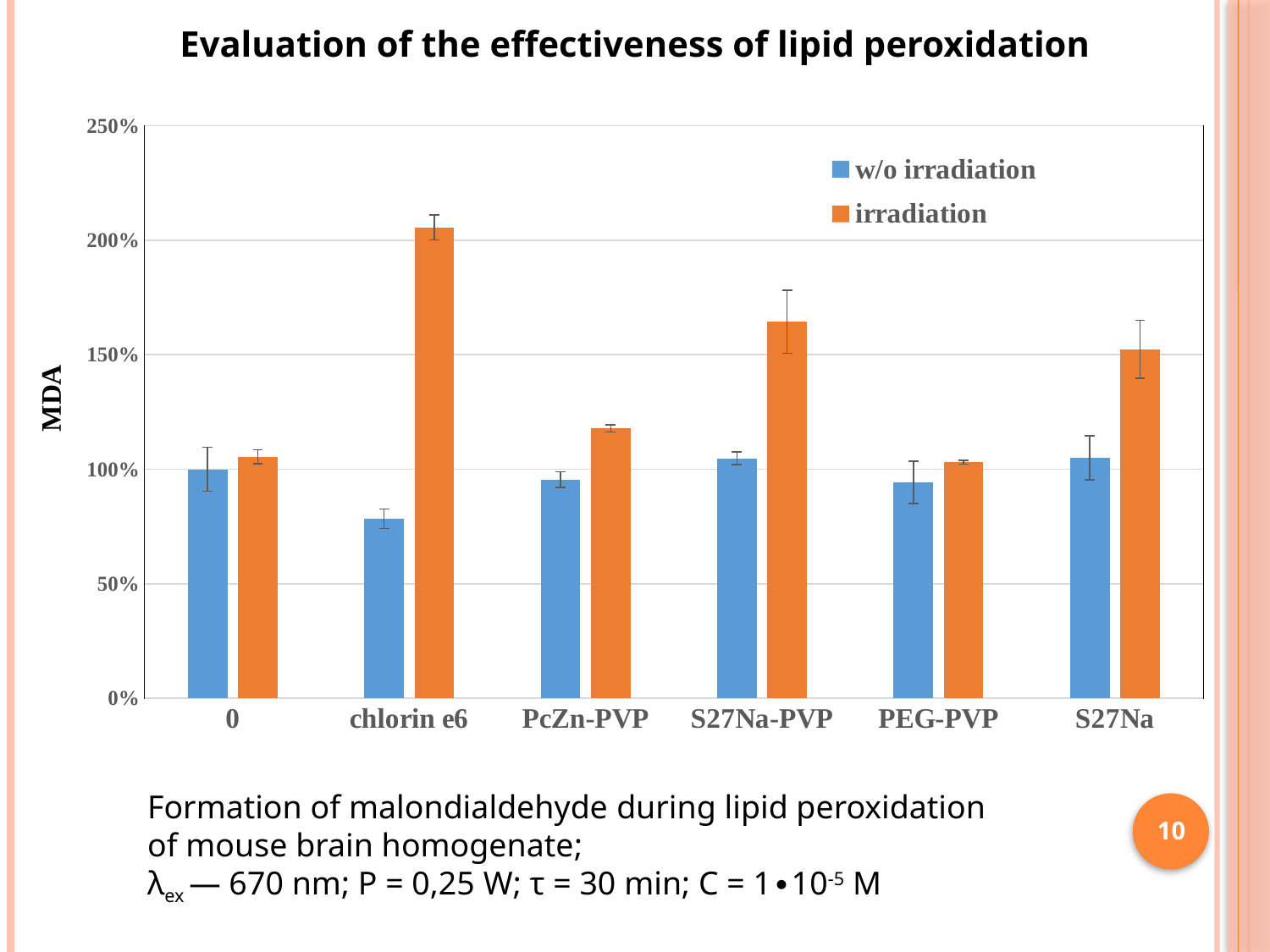
Which is larger: the irradiation value for chlorin e6 or the irradiation value for S27Na-PVP? chlorin e6 What is the label of the y axis? MDA Which category has the highest value for the irradiation series? chlorin e6 Which is larger: the irradiation value for PcZn-PVP or the irradiation value for PEG-PVP? PcZn-PVP How many categories are shown on the x axis? 6 Is the irradiation value for S27Na-PVP greater or less than 150%? greater Is the w/o irradiation value for chlorin e6 greater or less than 100%? less How many series does the legend list? 2 Is the irradiation value for PcZn-PVP greater or less than 100%? greater Which category has the lowest value for the w/o irradiation series? chlorin e6 What kind of chart is shown on the slide? bar chart